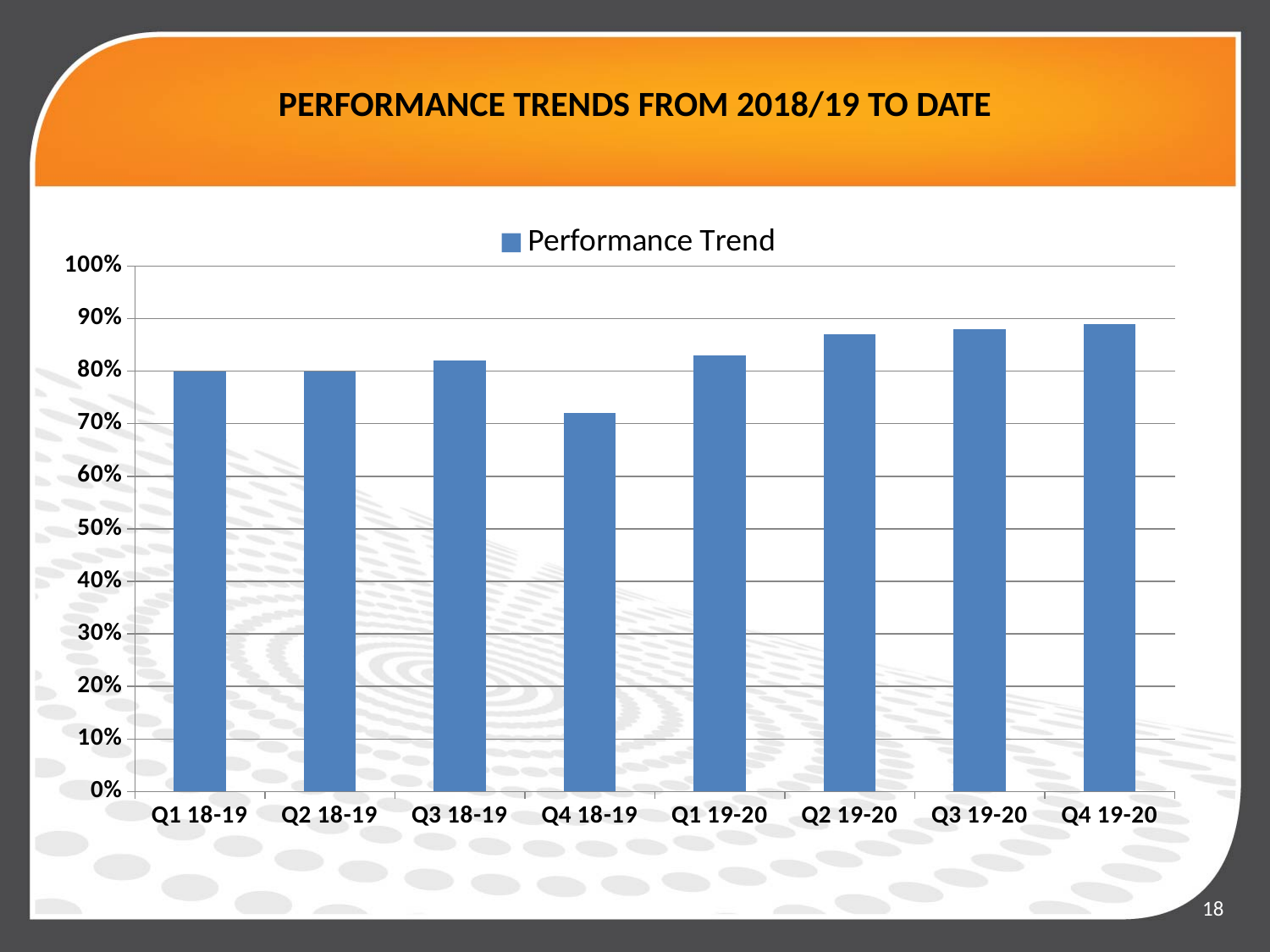
How many series does the chart's legend list? 1 What kind of chart is shown on the slide? bar chart Do the values rise or fall from Q4 18-19 through Q4 19-20? rise How many quarters are plotted on the x axis of the chart? 8 What is the name of the series shown in the chart's legend? Performance Trend Which quarter has the lowest value in the chart? Q4 18-19 Is the value for Q2 19-20 greater or less than 80%? greater Which is larger, the value for Q4 18-19 or the value for Q1 19-20? Q1 19-20 Is the value for Q4 18-19 greater or less than 80%? less Which is larger, the value for Q3 18-19 or the value for Q2 19-20? Q2 19-20 Is the value for Q3 18-19 greater or less than 90%? less